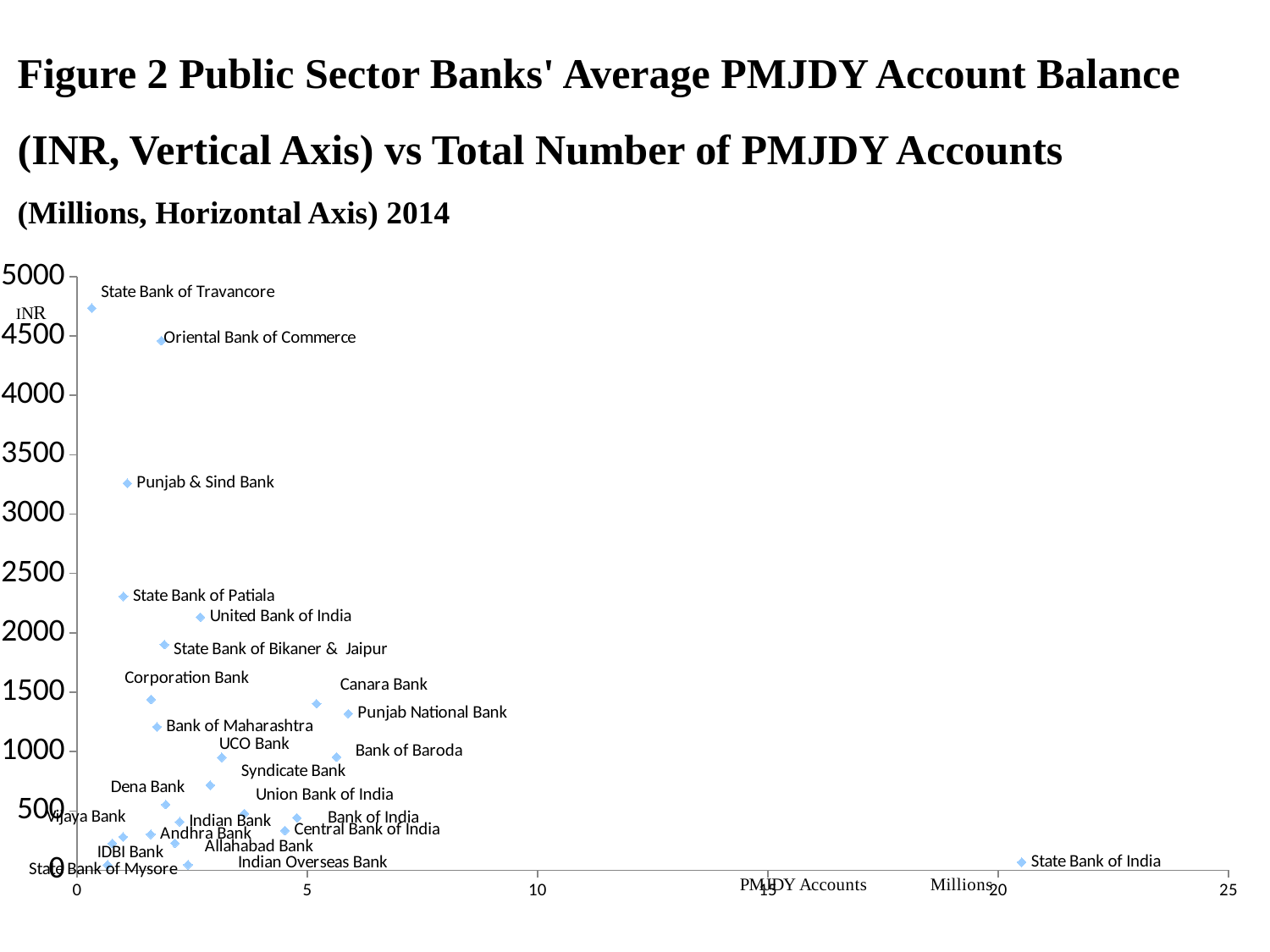
Which bank has the highest average PMJDY account balance (vertical axis)? State Bank of Travancore Which has a higher average account balance, Punjab & Sind Bank or State Bank of Patiala? Punjab & Sind Bank Is the average account balance for Syndicate Bank greater or less than 1000? less What unit is shown as the label of the vertical axis? INR Is the average account balance for Bank of Maharashtra greater or less than 1500? less How many banks are plotted on the chart? 25 What kind of chart is shown on the slide? scatter chart Is the average account balance for Punjab & Sind Bank greater or less than 3000? greater Which has a higher average account balance, Canara Bank or Punjab National Bank? Canara Bank Which bank has the largest total number of PMJDY accounts (horizontal axis)? State Bank of India